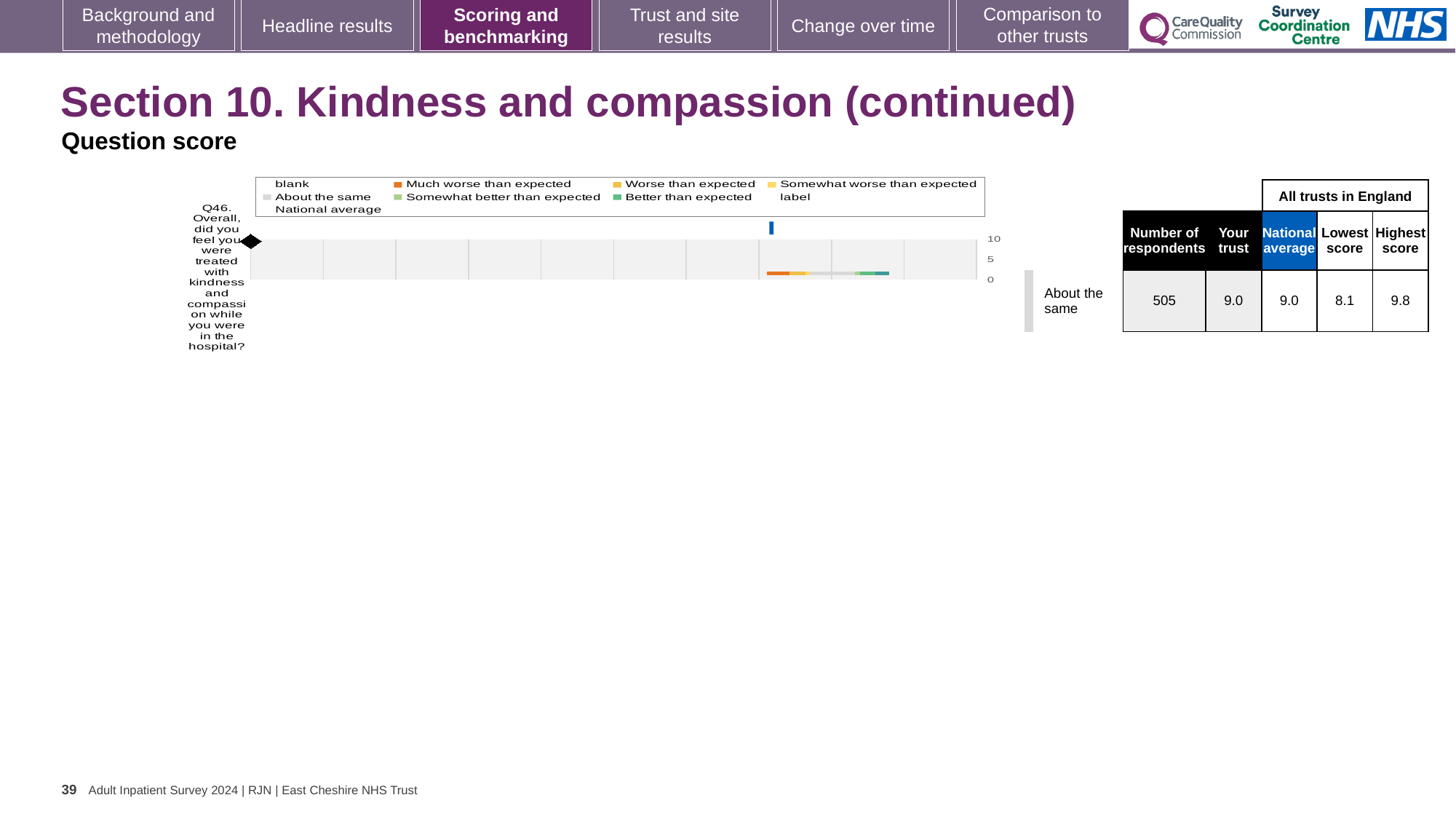
What kind of chart is used to show the Q46 question score? bar chart What is the Lowest score among all trusts in England for Q46? 8.1 Which question number does the chart on this slide cover? Q46 What is the Highest score among all trusts in England for Q46? 9.8 Is the National average for Q46 greater or less than 5 on the chart's axis? greater What is the score for Your trust on Q46? 9.0 How many respondents answered Q46? 505 What is the National average score for Q46? 9.0 What is the difference between the Highest score and the Lowest score for Q46? 1.7 Is the trust's Q46 score higher than, lower than, or the same as the National average? the same Which benchmarking category is the trust's Q46 score placed in? About the same Which legend entry is shown in orange on the Q46 chart? Much worse than expected